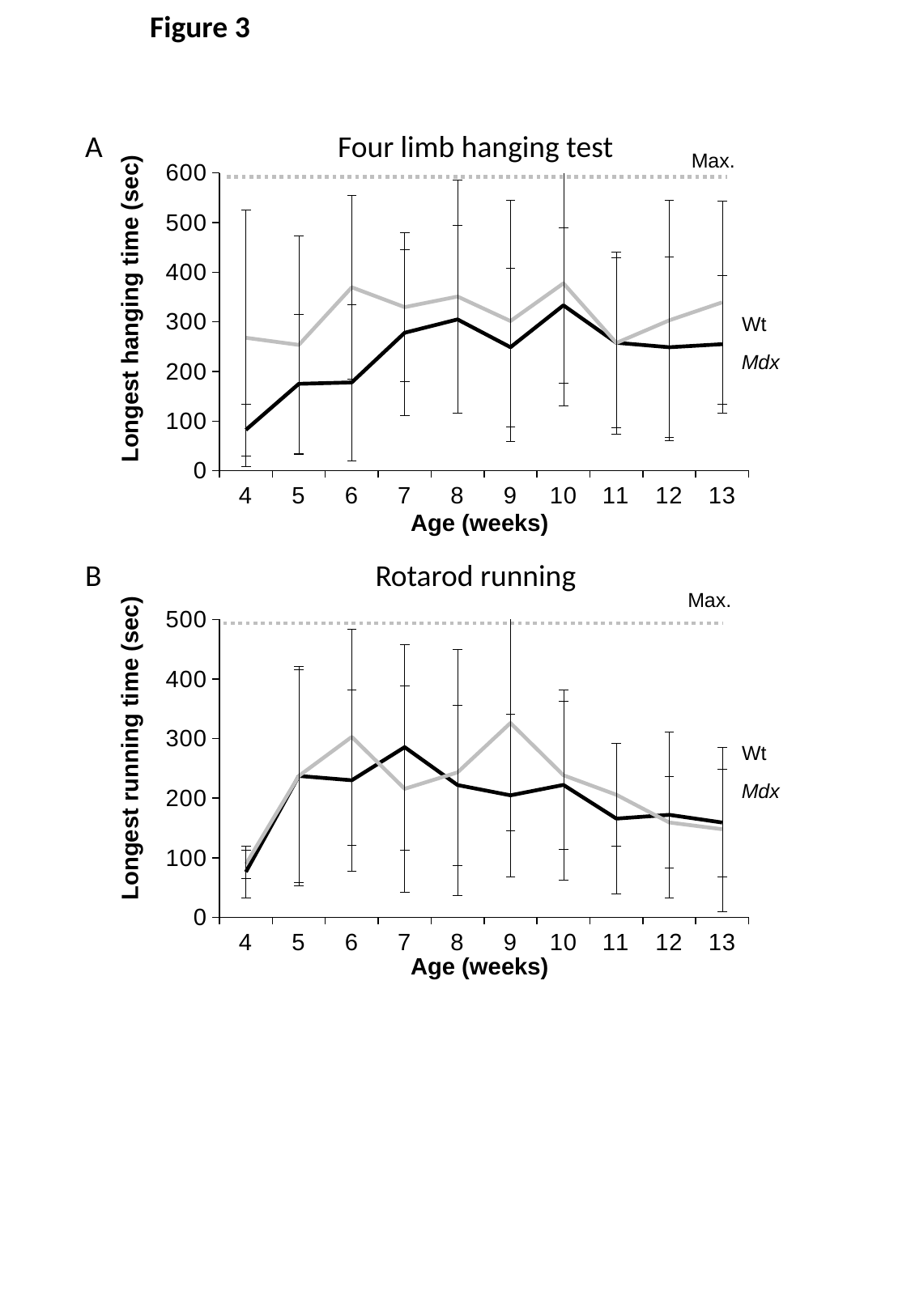
In the "Rotarod running" chart, how many age points are shown on the x axis? 10 In the "Four limb hanging test" chart, at which age is the Mdx value lowest? 4 weeks In the "Four limb hanging test" chart, which series has the larger value at 4 weeks, Wt or Mdx? Wt In the "Four limb hanging test" chart, is the Mdx value at 4 weeks greater or less than 100? less In the "Rotarod running" chart, is the Wt value at 9 weeks greater or less than 300? greater What kind of chart is the "Four limb hanging test" chart? line chart In the "Four limb hanging test" chart, how many series are plotted? 2 In the "Rotarod running" chart, which series has the larger value at 7 weeks, Wt or Mdx? Mdx In the "Rotarod running" chart, at what value is the dotted "Max." line drawn? 500 In the "Rotarod running" chart, at which age is the Wt value highest? 9 weeks In the "Four limb hanging test" chart, is the Wt value at 6 weeks greater or less than 300? greater In the "Rotarod running" chart, does the Mdx value rise or fall from 10 weeks to 13 weeks? fall